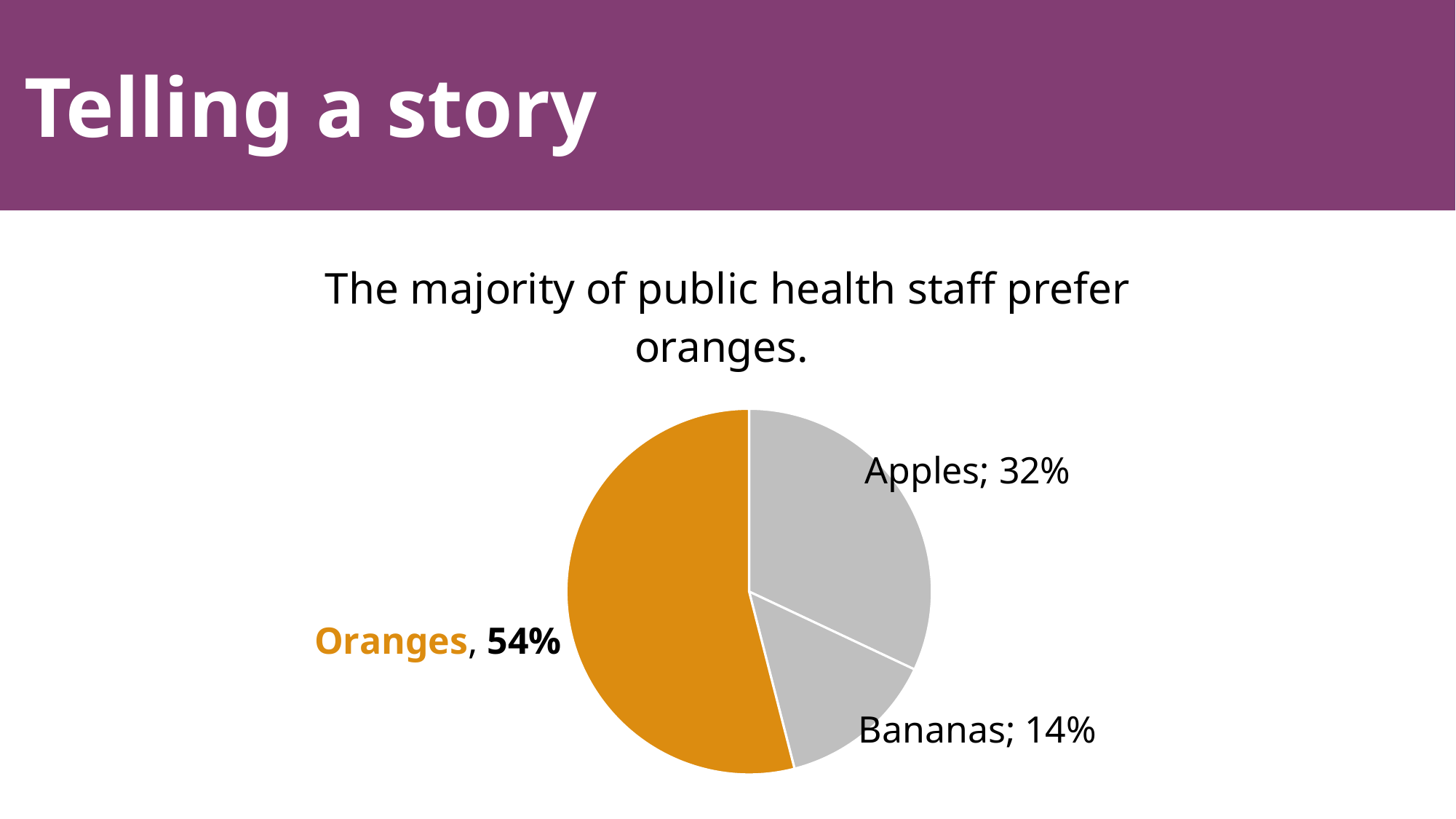
What is the difference in percentage points between Oranges and Apples? 22 Which category has the largest slice of the pie chart? Oranges Which category has the smallest slice of the pie chart? Bananas What percentage of the pie chart is Oranges? 54% What percentage of the pie chart is Bananas? 14% What kind of chart is shown on the slide? Pie chart How many categories are shown in the pie chart? 3 Which slice of the pie chart is coloured orange? Oranges What is the difference in percentage points between Apples and Bananas? 18 What percentage of the pie chart is Apples? 32% Which is larger, the share for Apples or the share for Bananas? Apples What is the title of the chart? The majority of public health staff prefer oranges.